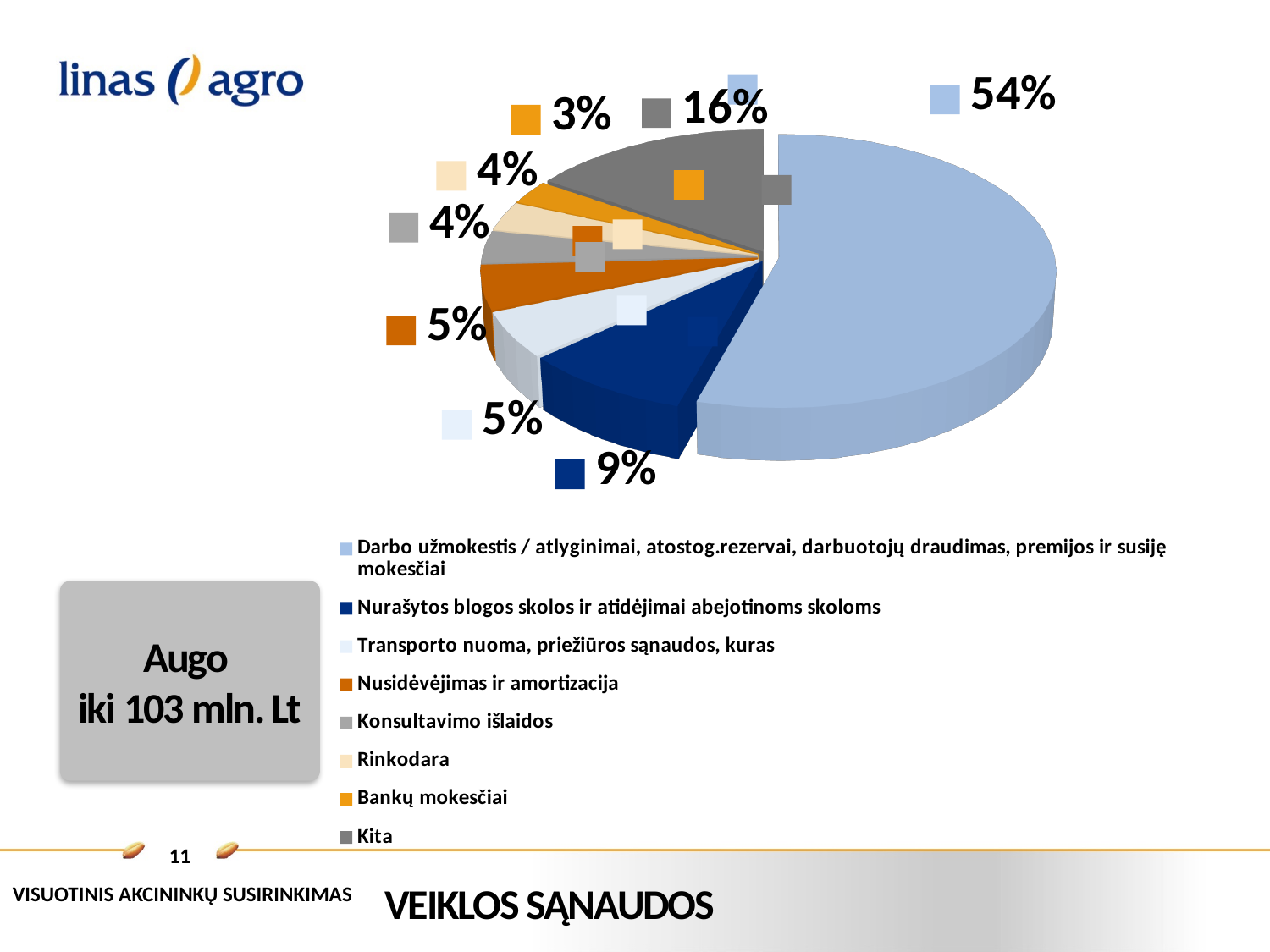
What share of the pie does "Nusidėvėjimas ir amortizacija" take? 5% What share of the pie does "Kita" take? 16% Which is larger: the share for "Kita" or the share for "Nurašytos blogos skolos ir atidėjimai abejotinoms skoloms"? Kita Which category has the largest slice of the pie? Darbo užmokestis / atlyginimai, atostog.rezervai, darbuotojų draudimas, premijos ir susiję mokesčiai What is the difference in percentage points between the largest slice (54%) and the "Kita" slice (16%)? 38 What share of the pie does "Darbo užmokestis / atlyginimai, atostog.rezervai, darbuotojų draudimas, premijos ir susiję mokesčiai" take? 54% How many categories does the legend list? 8 Which category has the smallest slice of the pie? Bankų mokesčiai What kind of chart is shown on the slide? Pie chart What is the title shown at the bottom of the slide for this chart? VEIKLOS SĄNAUDOS